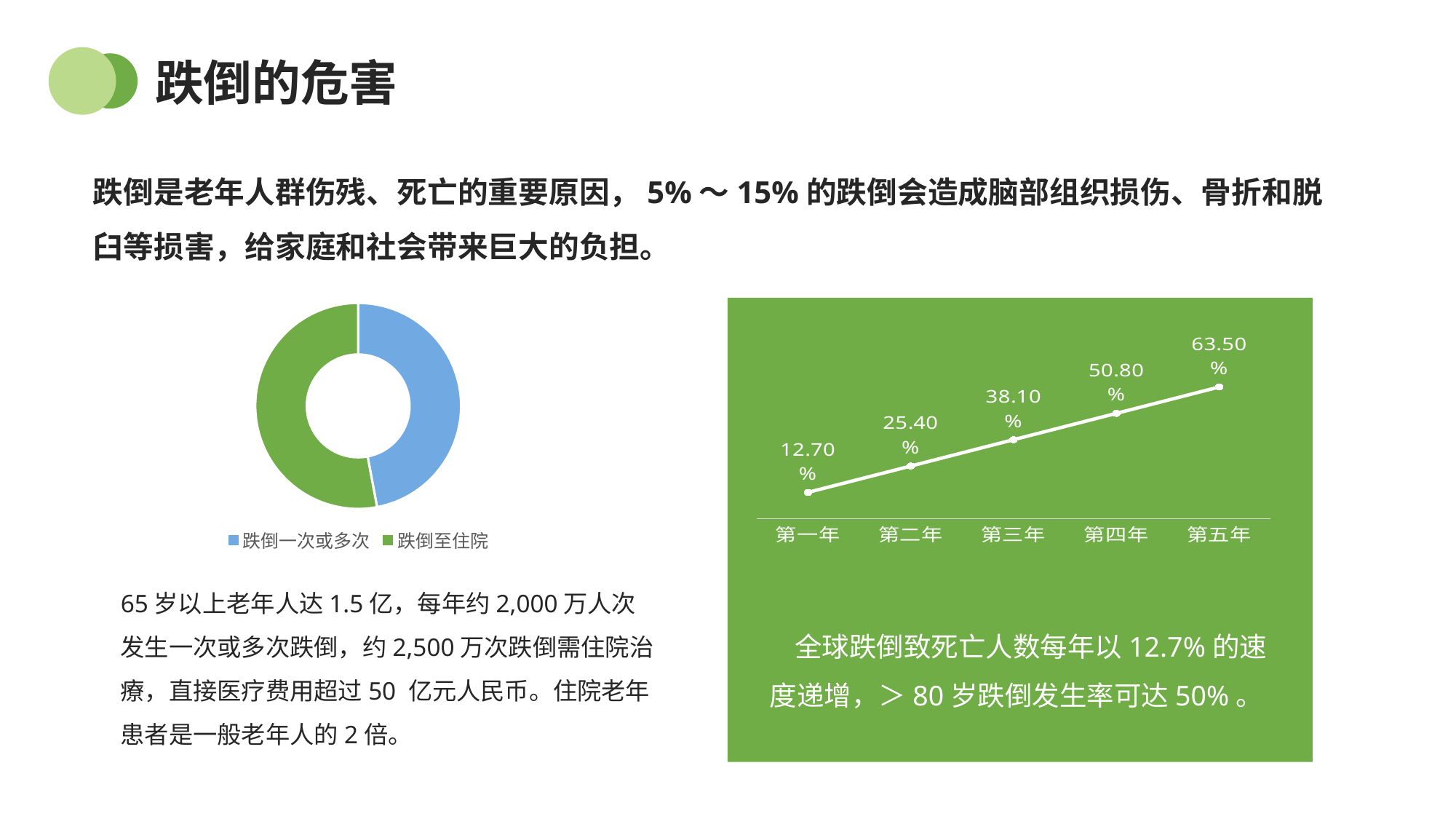
On the line chart on the right, what is the value for 第一年? 12.70% On the line chart on the right, which year has the lowest value? 第一年 On the line chart on the right, what is the difference between the values for 第二年 and 第一年? 12.70% On the line chart on the right, do the values rise or fall from 第一年 to 第五年? rise On the line chart on the right, which is larger, the value for 第四年 or 第二年? 第四年 On the line chart on the right, what is the value for 第五年? 63.50% On the line chart on the right, which year has the highest value? 第五年 On the line chart on the right, what is the difference between the values for 第五年 and 第一年? 50.80% How many entries does the legend of the donut chart on the left list? 2 On the line chart on the right, what is the value for 第三年? 38.10% On the line chart on the right, how many data points are plotted? 5 What kind of chart is shown on the left of the slide? donut (pie) chart